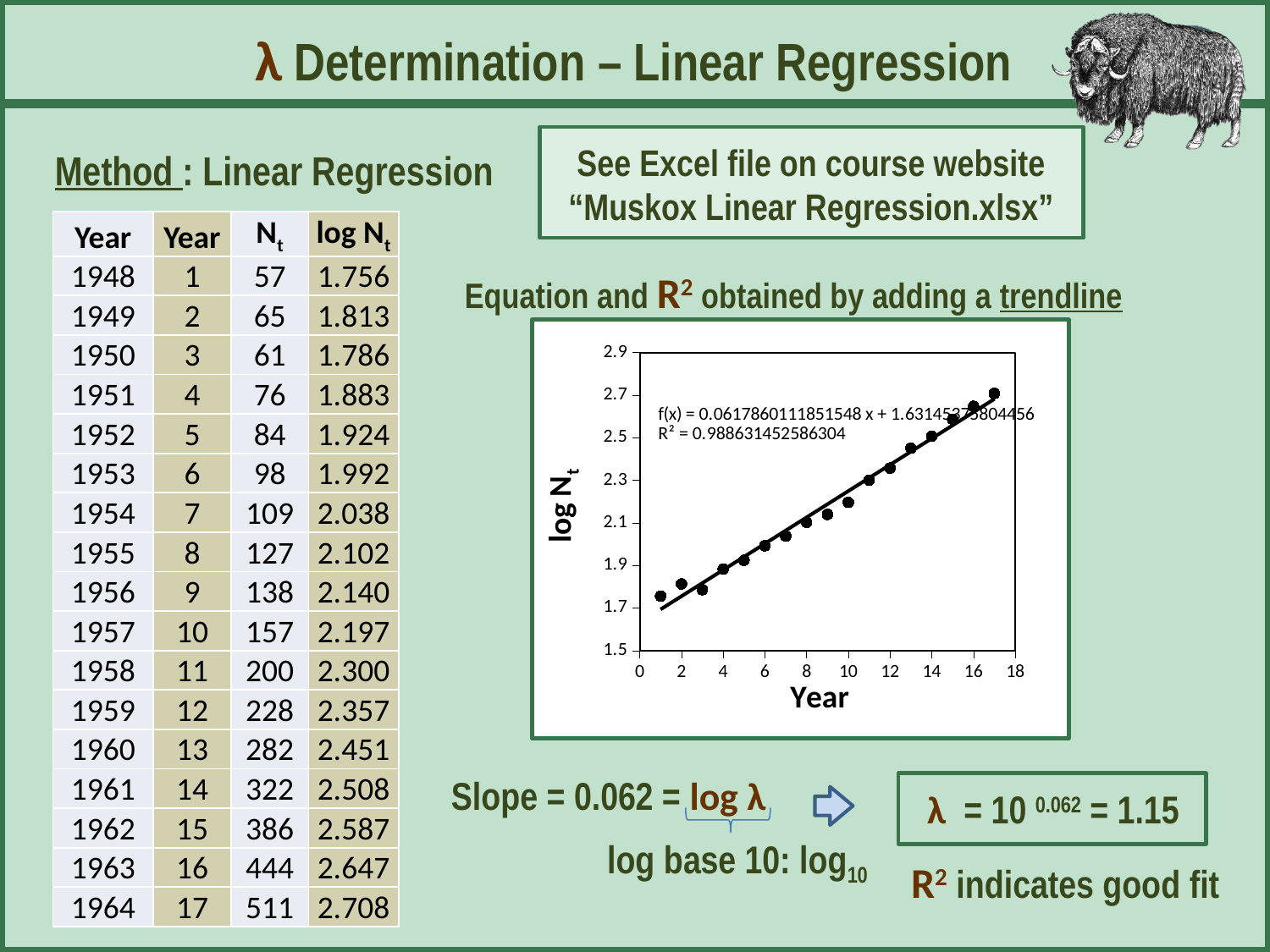
Do the plotted log Nt values rise or fall as Year increases along the x axis? rise What is the R² value shown on the chart? 0.988631452586304 How many data points are plotted in the chart? 17 What kind of chart is shown on the slide? scatter chart with a trendline Is the plotted value for Year 10 greater or less than 2.1? greater Which has the larger plotted log Nt value, Year 14 or Year 4? Year 14 According to the table on the slide, what is the log Nt value plotted for Year 11? 2.300 Is the plotted value for Year 1 greater or less than 1.9? less Is the plotted value for Year 17 greater or less than 2.5? greater Which Year has the highest plotted log Nt value? 17 What is the label of the y axis of the chart? log Nt